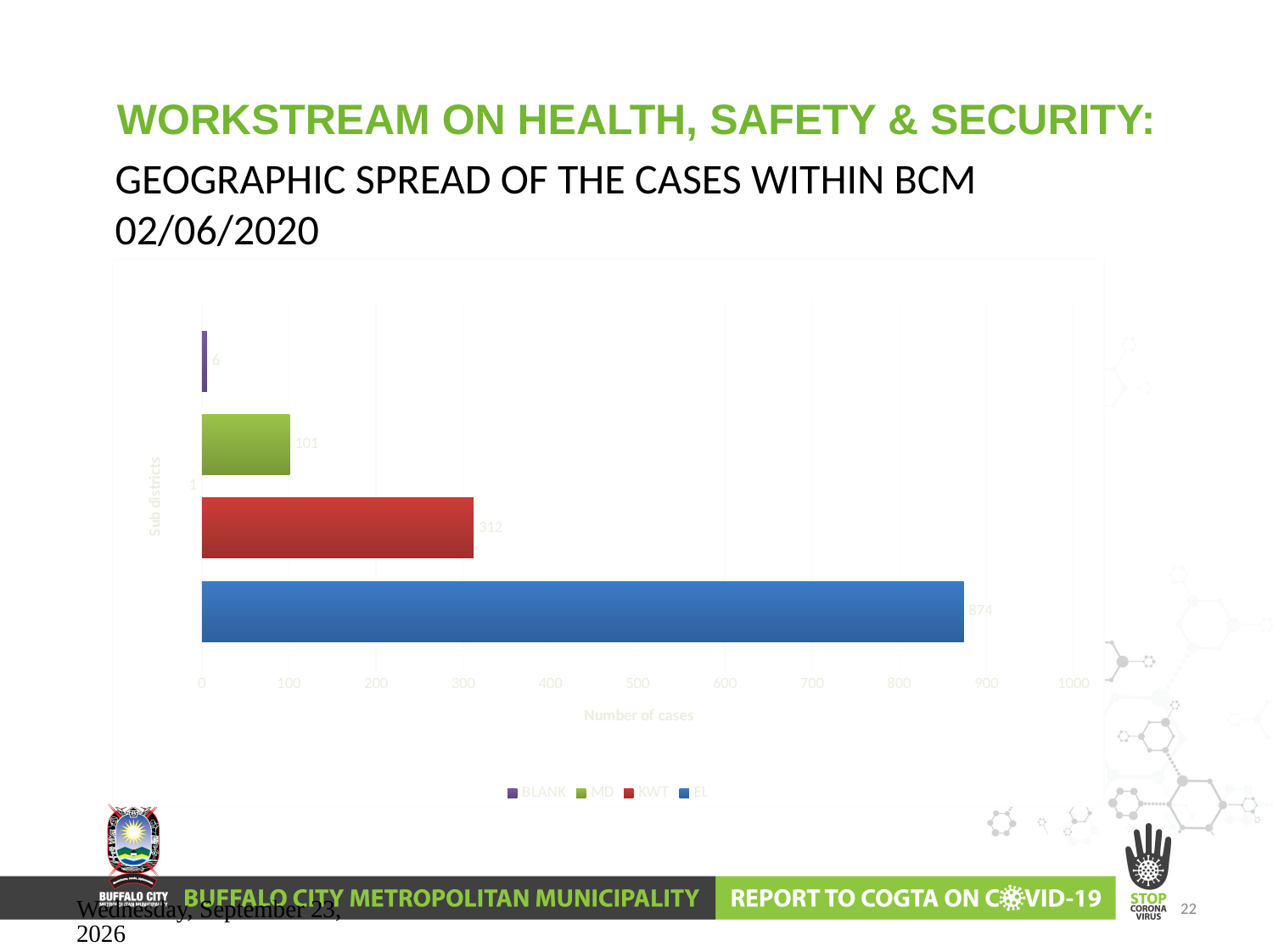
What kind of chart is shown on the slide? bar chart How many cases are shown for BLANK? 6 What is the difference in cases between EL and KWT? 562 How many cases are shown for MD? 101 How many series does the legend list? 4 Which has more cases, MD or KWT? KWT What is the label of the horizontal axis? Number of cases How many cases are shown for EL? 874 How many cases are shown for KWT? 312 Which series has the lowest number of cases? BLANK What is the difference in cases between KWT and MD? 211 Which series has the highest number of cases? EL